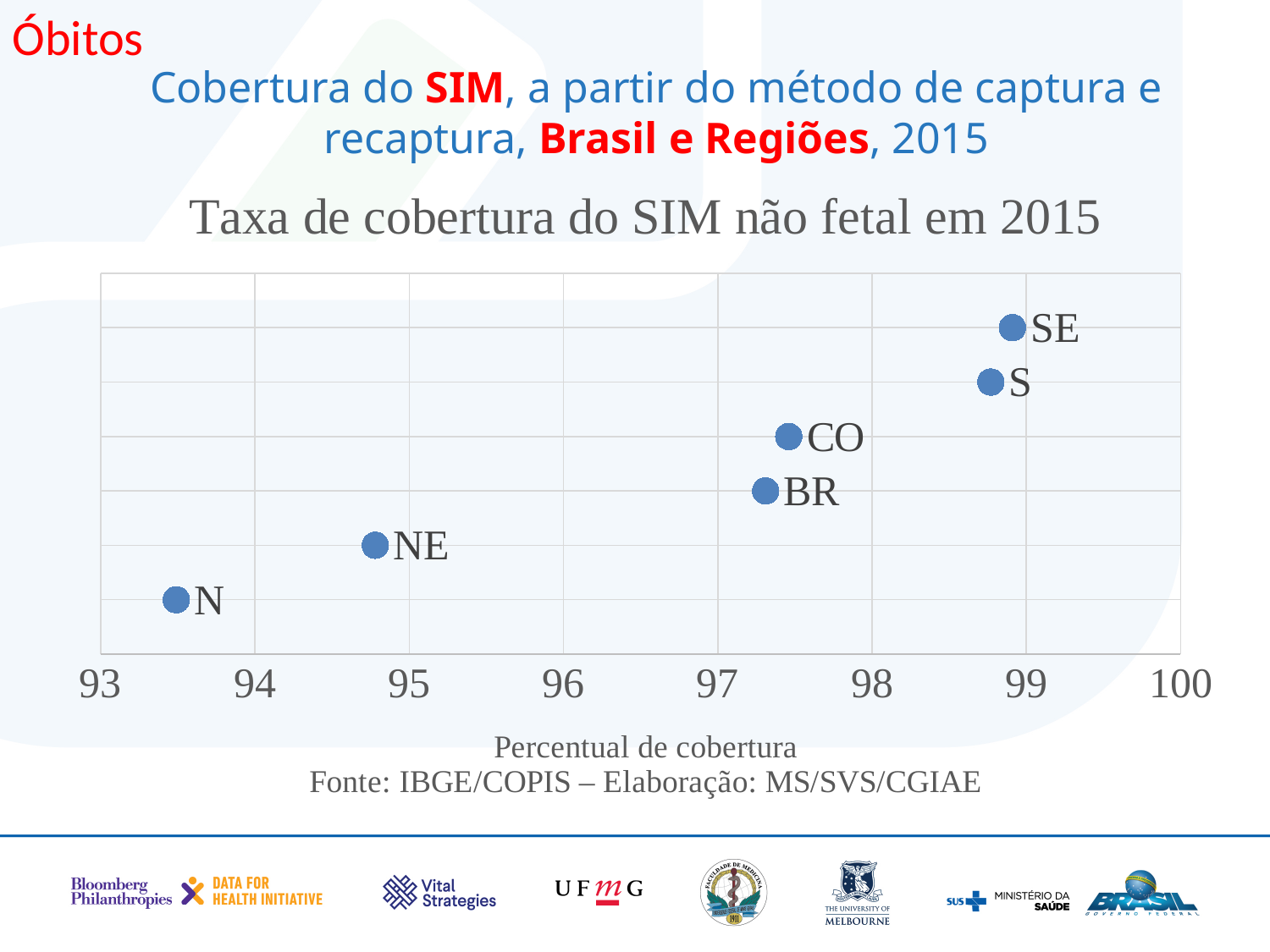
How many data points are plotted in the chart? 6 Is the coverage value for CO greater or less than 97? greater Is the coverage value for NE greater or less than 95? less What is the title of the chart? Taxa de cobertura do SIM não fetal em 2015 Is the coverage value for SE greater or less than 98? greater Which has a higher coverage percentage, NE or N? NE Which has a higher coverage percentage, S or CO? S What kind of chart is shown on the slide? scatter chart Which region has the lowest coverage percentage in the chart? N